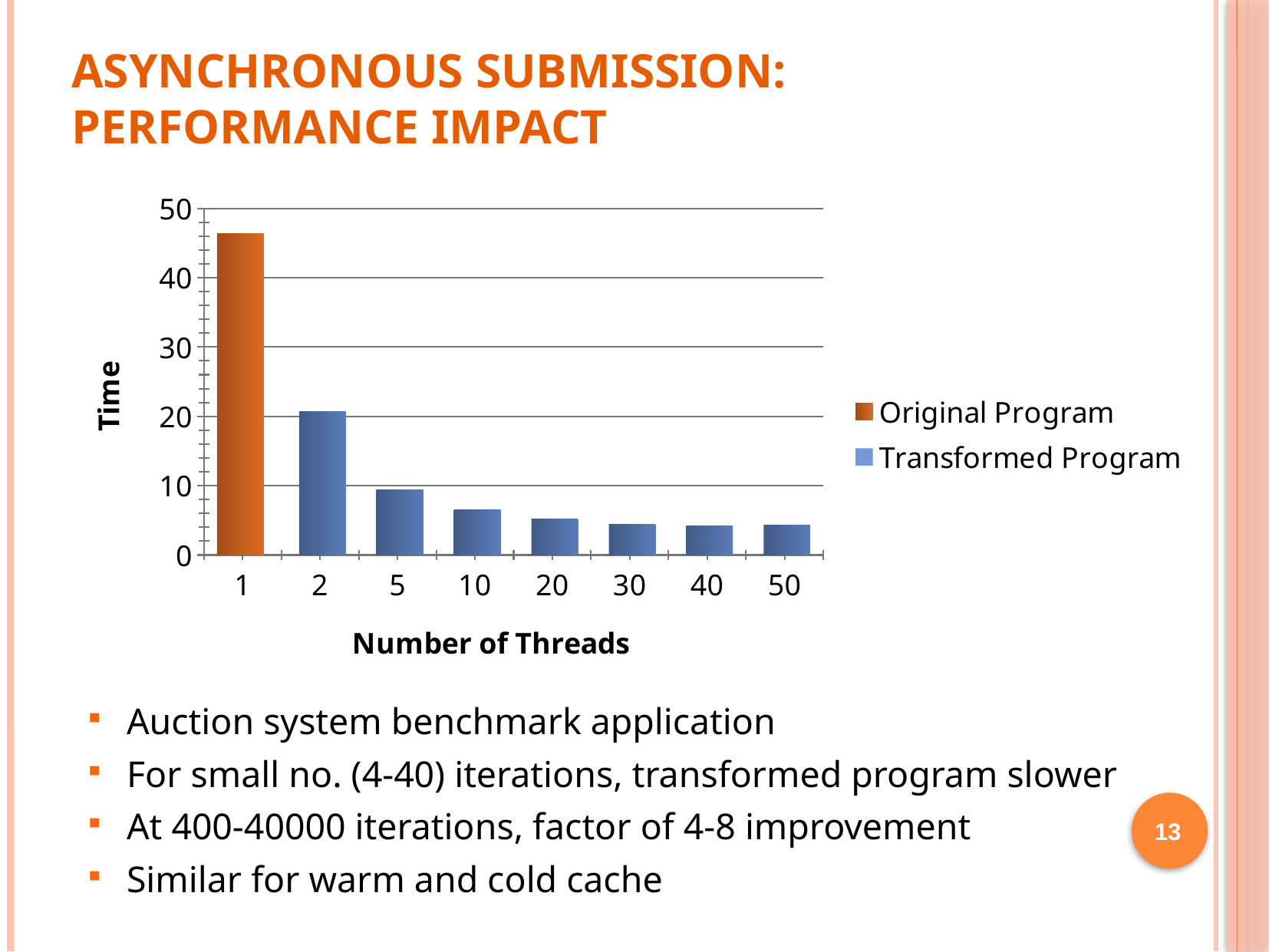
How many series does the legend list? 2 What kind of chart is shown on the slide? bar chart Is the time for 2 threads greater or less than 30? less Is the time for 1 thread greater or less than 40? greater Which has a larger time value, 2 threads or 5 threads? 2 threads Which number of threads has the highest time value? 1 What is the label of the x axis? Number of Threads How many thread-count categories are shown on the x axis? 8 Do the time values rise or fall as the number of threads increases along the x axis? fall Which series is shown in orange in the legend? Original Program Is the time for 50 threads greater or less than 10? less